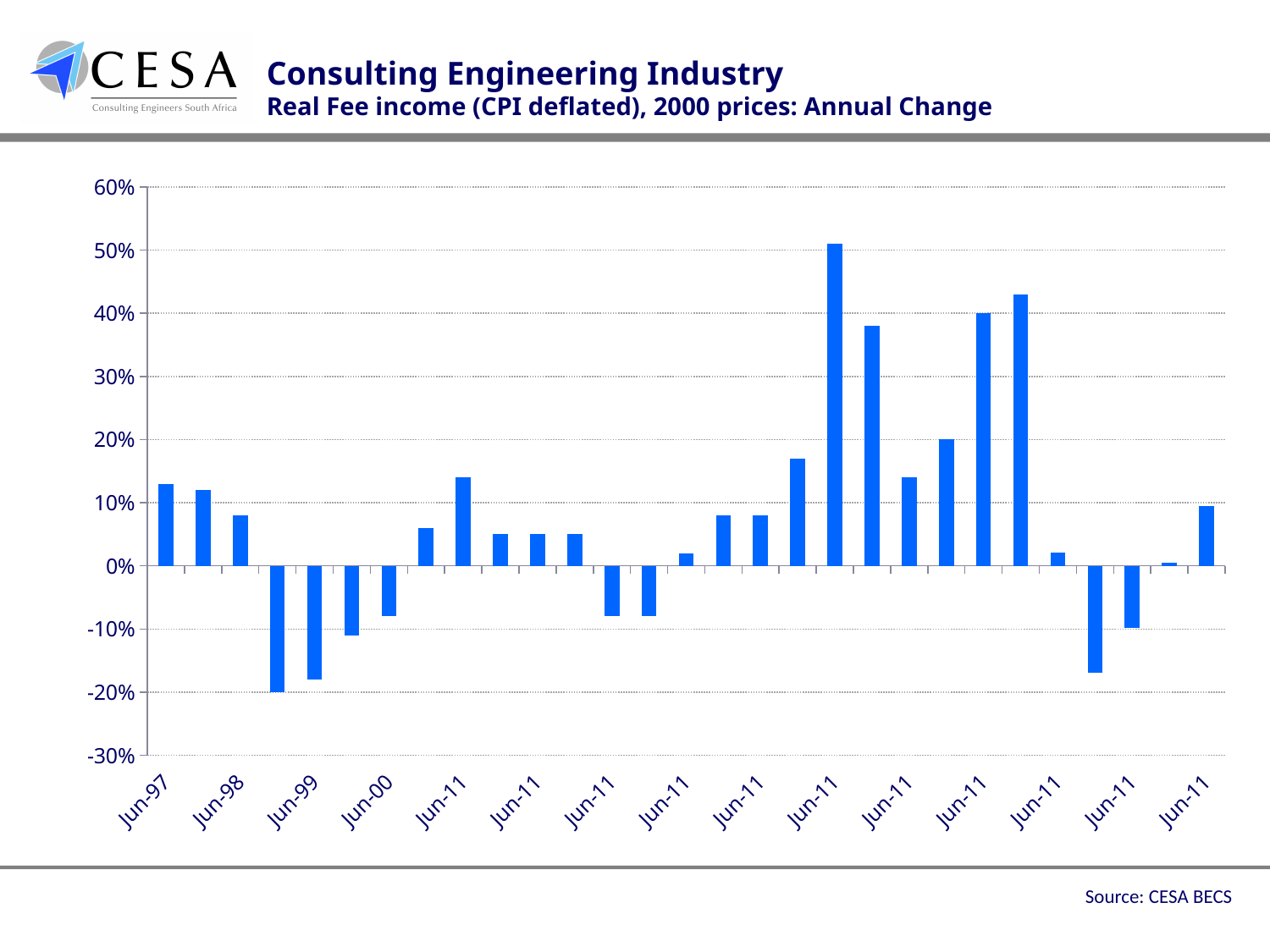
Is the tallest bar on the chart greater or less than 40%? greater What is the subtitle of the chart on the slide? Real Fee income (CPI deflated), 2000 prices: Annual Change Is the value for Jun-99 greater or less than -10%? less Is the lowest bar on the chart greater or less than -10%? less Which is larger, the value for Jun-99 or the value for Jun-00? Jun-00 What kind of chart is shown on the slide? bar chart Do the values rise or fall from Jun-97 to Jun-99? fall Which is larger, the value for Jun-97 or the value for Jun-99? Jun-97 What source is cited for the chart? CESA BECS